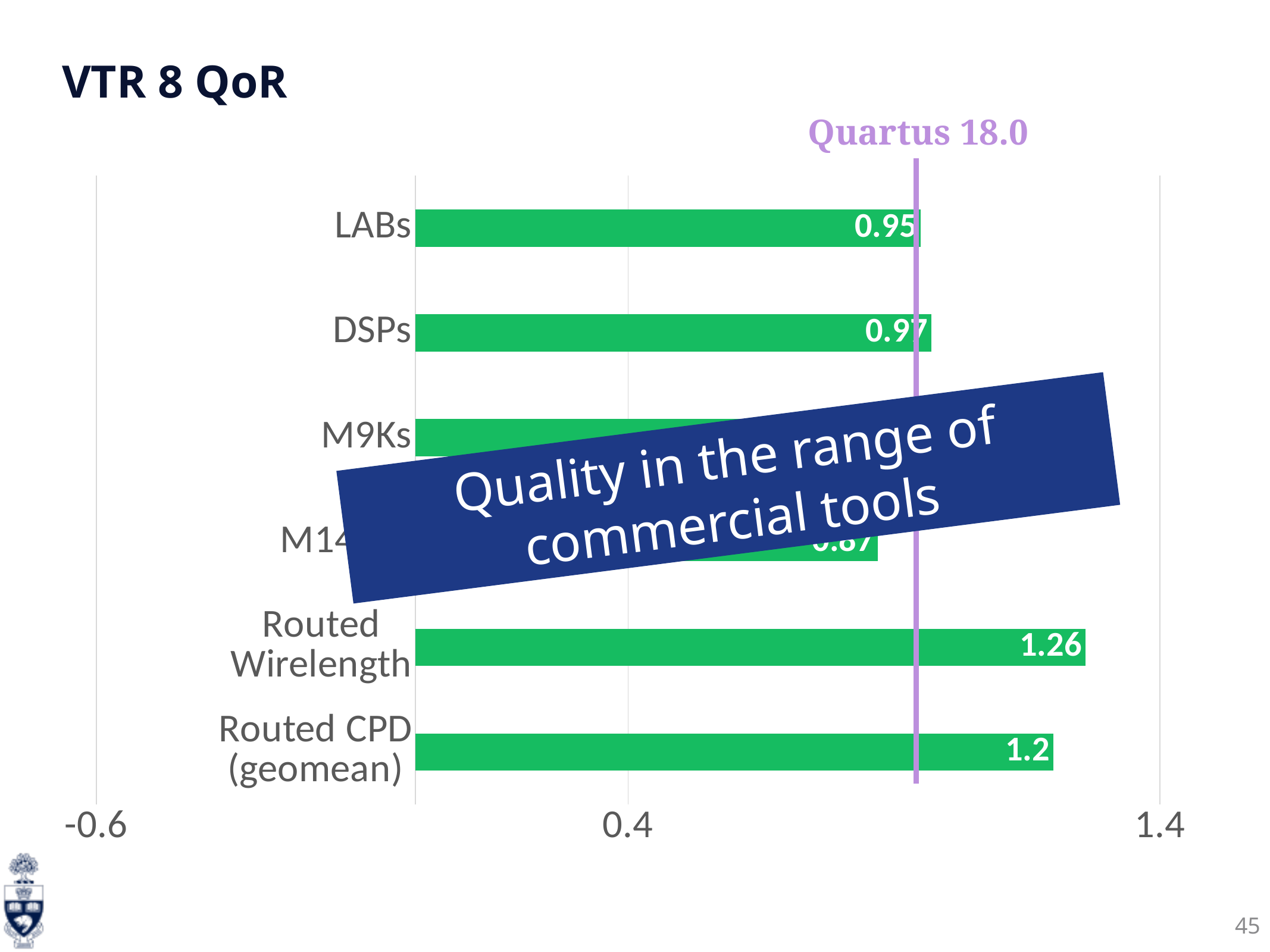
What is the value for Routed Wirelength? 1.26 What is the difference between the values for Routed Wirelength and Routed CPD (geomean)? 0.06 What kind of chart is shown on the slide? bar chart Is the value for Routed Wirelength greater or less than 0.4? greater What is the label on the vertical purple reference line? Quartus 18.0 What is the value for LABs? 0.95 What is the value for Routed CPD (geomean)? 1.2 What is the value for DSPs? 0.97 What is the difference between the values for DSPs and LABs? 0.02 Which is larger, the value for DSPs or the value for LABs? DSPs How many categories are shown on the chart? 6